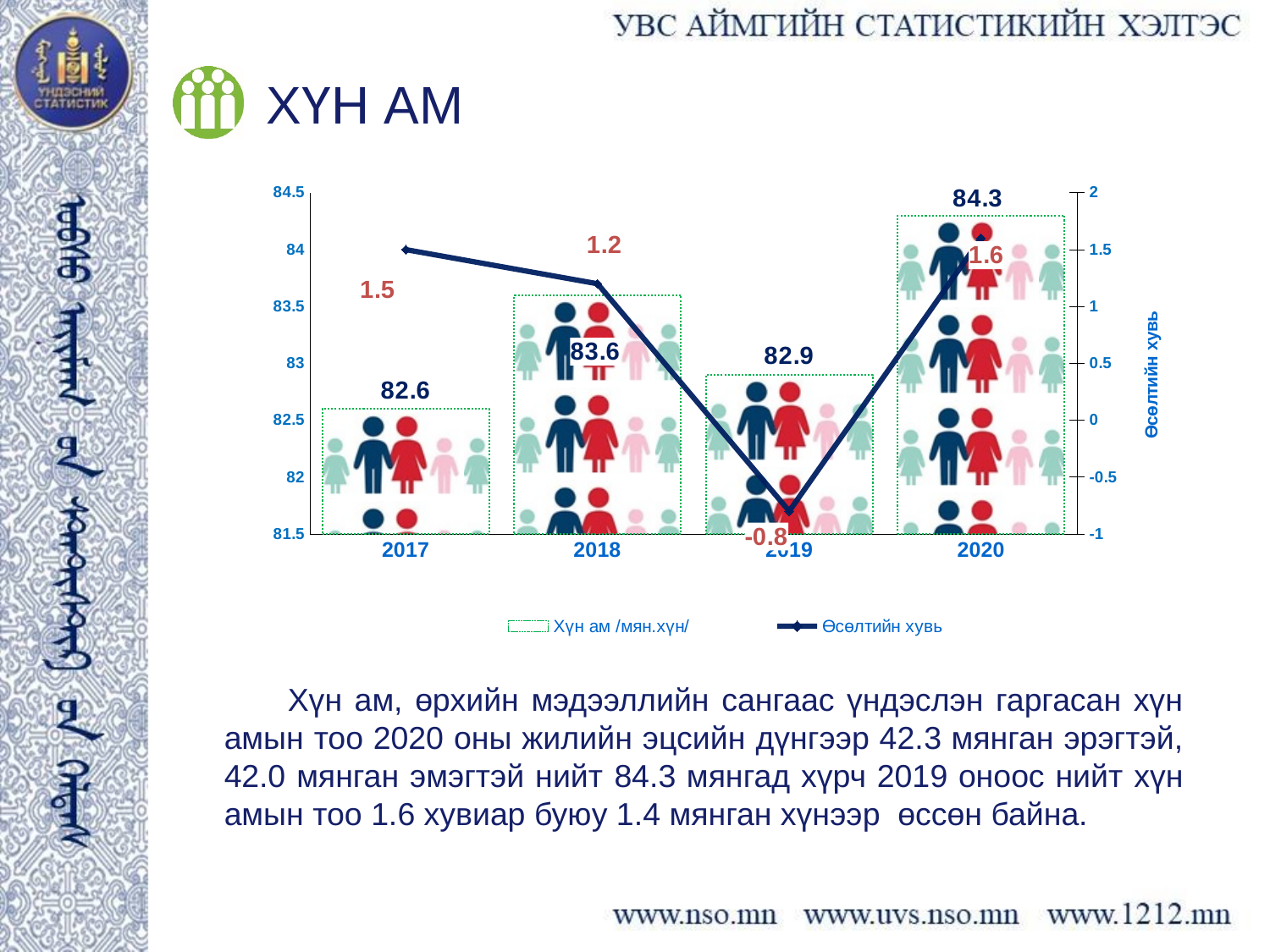
What kind of chart is shown on the slide? Combined bar and line chart What is the label of the right-hand (secondary) vertical axis of the chart? Өсөлтийн хувь What is the growth rate (Өсөлтийн хувь) value shown for 2019? -0.8 What is the growth rate (Өсөлтийн хувь) value shown for 2018? 1.2 What is the population (Хүн ам /мян.хүн/) value shown for 2020? 84.3 How many years are shown on the x axis of the chart? 4 How many series does the chart legend list? 2 What is the population (Хүн ам /мян.хүн/) value shown for 2017? 82.6 What is the difference between the population values for 2020 and 2019? 1.4 Which year has the lowest growth rate (Өсөлтийн хувь) value? 2019 Which is larger, the population value for 2018 or for 2019? 2018 Which year has the highest population (Хүн ам /мян.хүн/) value? 2020